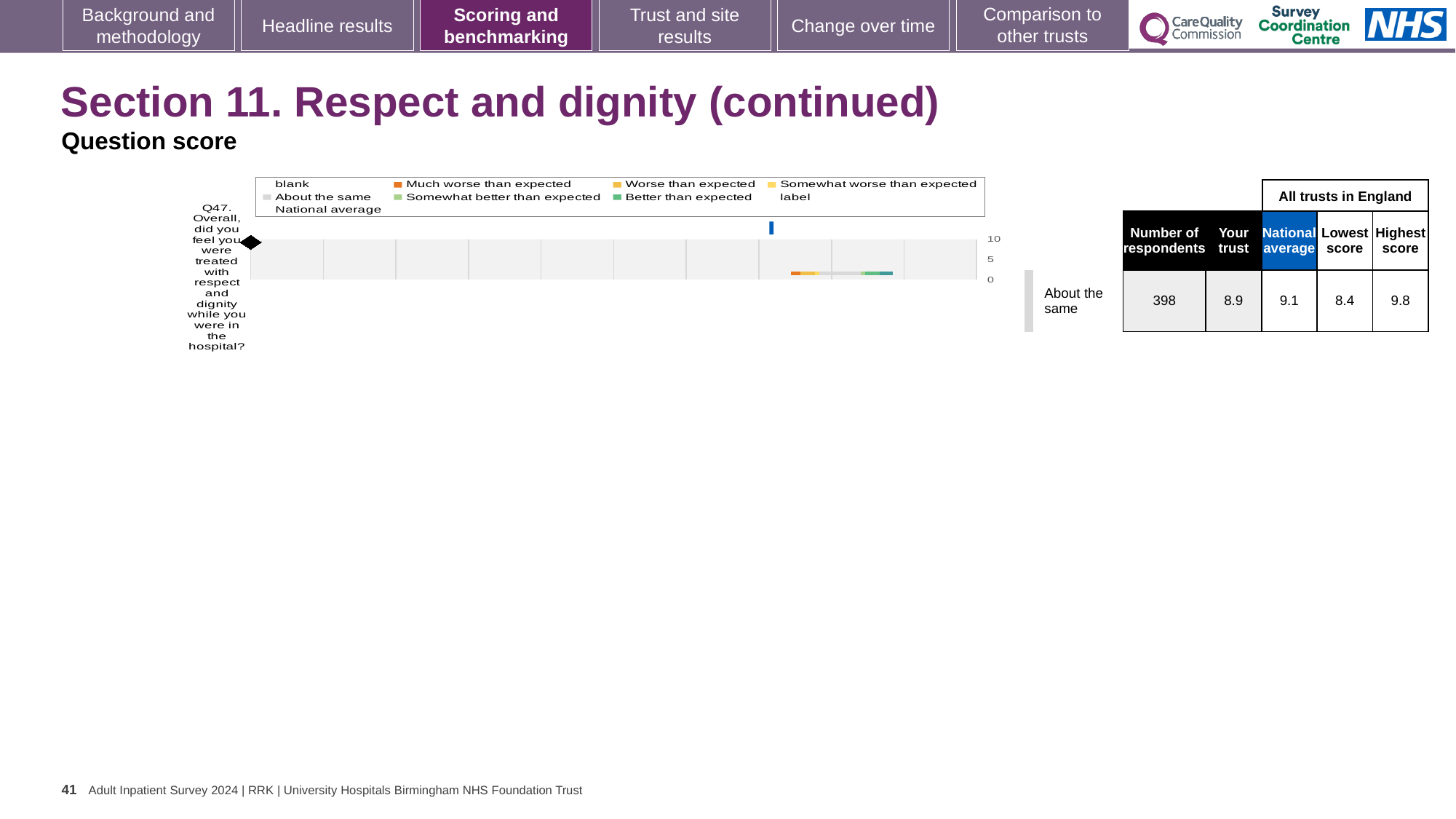
What colour does the legend use for 'Much worse than expected'? orange Which is larger for Q47, the 'Your trust' score or the national average? National average What is the difference between the highest score and the lowest score for Q47? 1.4 What is the number of respondents for Q47? 398 Which question number is plotted on the chart? Q47 What is the 'Your trust' score for Q47 shown next to the chart? 8.9 What is the lowest score among all trusts in England for Q47? 8.4 What is the national average score for Q47 shown next to the chart? 9.1 Which benchmark category is the trust's Q47 result placed in? About the same What is the highest score among all trusts in England for Q47? 9.8 What kind of chart is shown on the slide? bar chart How many questions (categories) are plotted on the chart? 1